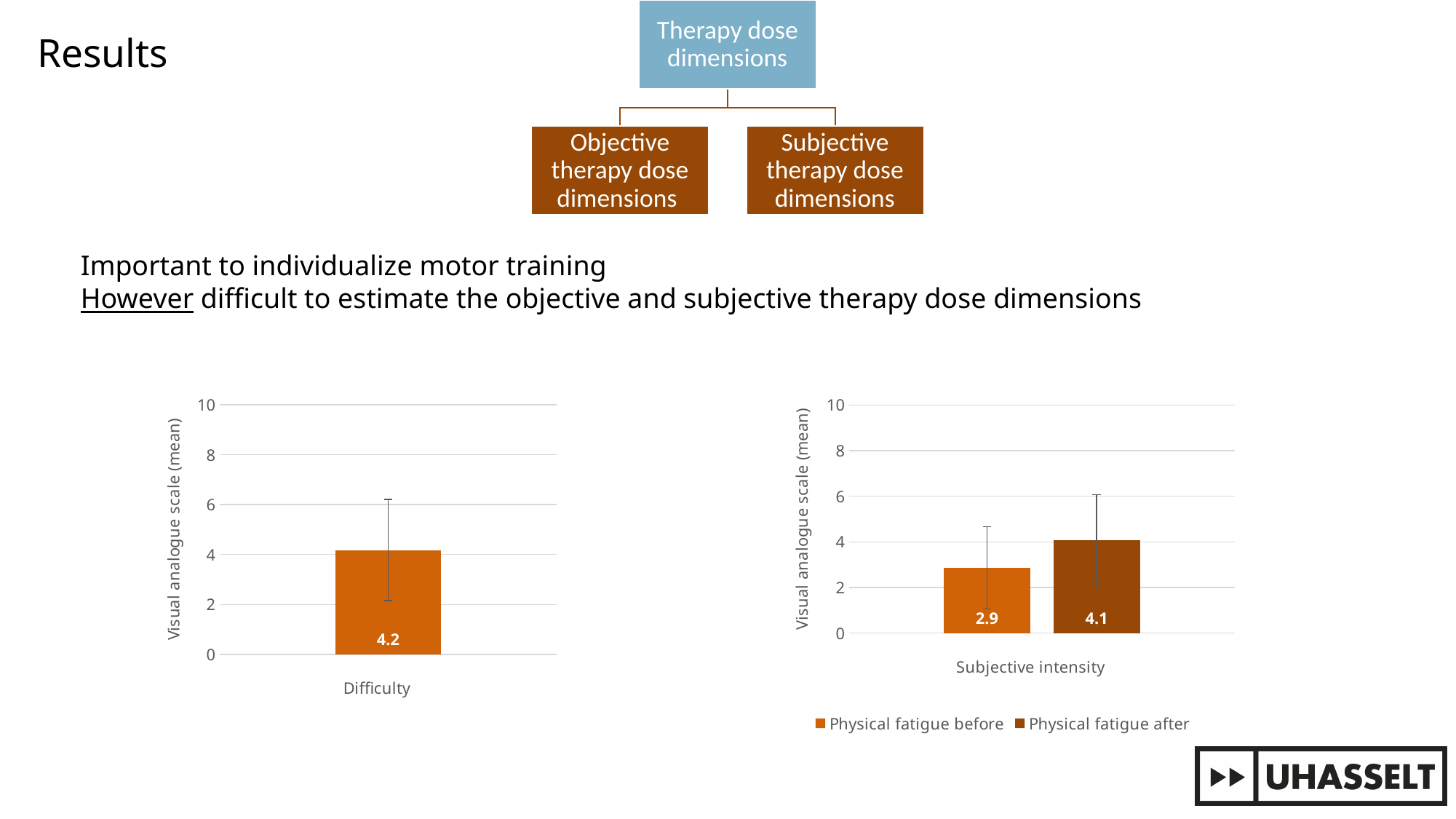
What is the category label on the x axis of the right chart? Subjective intensity In the right chart, is the value for Physical fatigue before greater or less than 2? greater In the right chart, which series has the higher value: Physical fatigue before or Physical fatigue after? Physical fatigue after In the right chart, how many bars are plotted? 2 In the right chart, how many series does the legend list? 2 In the right chart, what is the difference between Physical fatigue after and Physical fatigue before? 1.2 In the left chart, what is the value for Difficulty? 4.2 In the left chart, is the value for Difficulty greater or less than 6? less In the right chart, what is the value for Physical fatigue before? 2.9 What kind of chart is the left chart? Bar chart What is the y-axis label of the left chart? Visual analogue scale (mean) In the right chart, what is the value for Physical fatigue after? 4.1